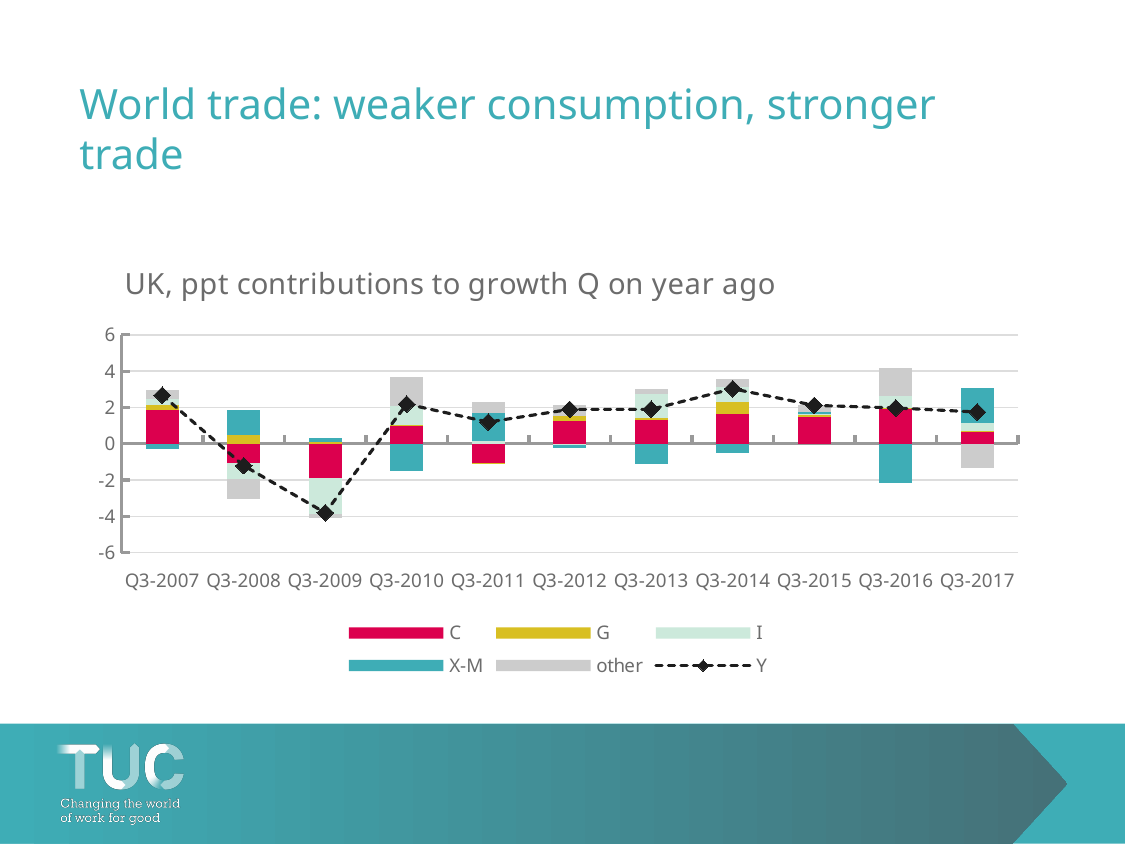
Is the value of Y for Q3-2009 greater or less than -2? less How many series does the chart's legend list? 6 In which quarter is the Y line at its lowest? Q3-2009 How many quarters are shown on the x axis of the chart? 11 Which has the higher Y value, Q3-2007 or Q3-2011? Q3-2007 What kind of chart is shown on the slide? Stacked bar chart with a line Is the value of Y for Q3-2007 greater or less than 2? greater Does the Y line rise or fall from Q3-2007 to Q3-2009? fall Is the value of Y for Q3-2014 greater or less than 2? greater What is the title of the chart? UK, ppt contributions to growth Q on year ago Which series is drawn as a dashed line with diamond markers? Y